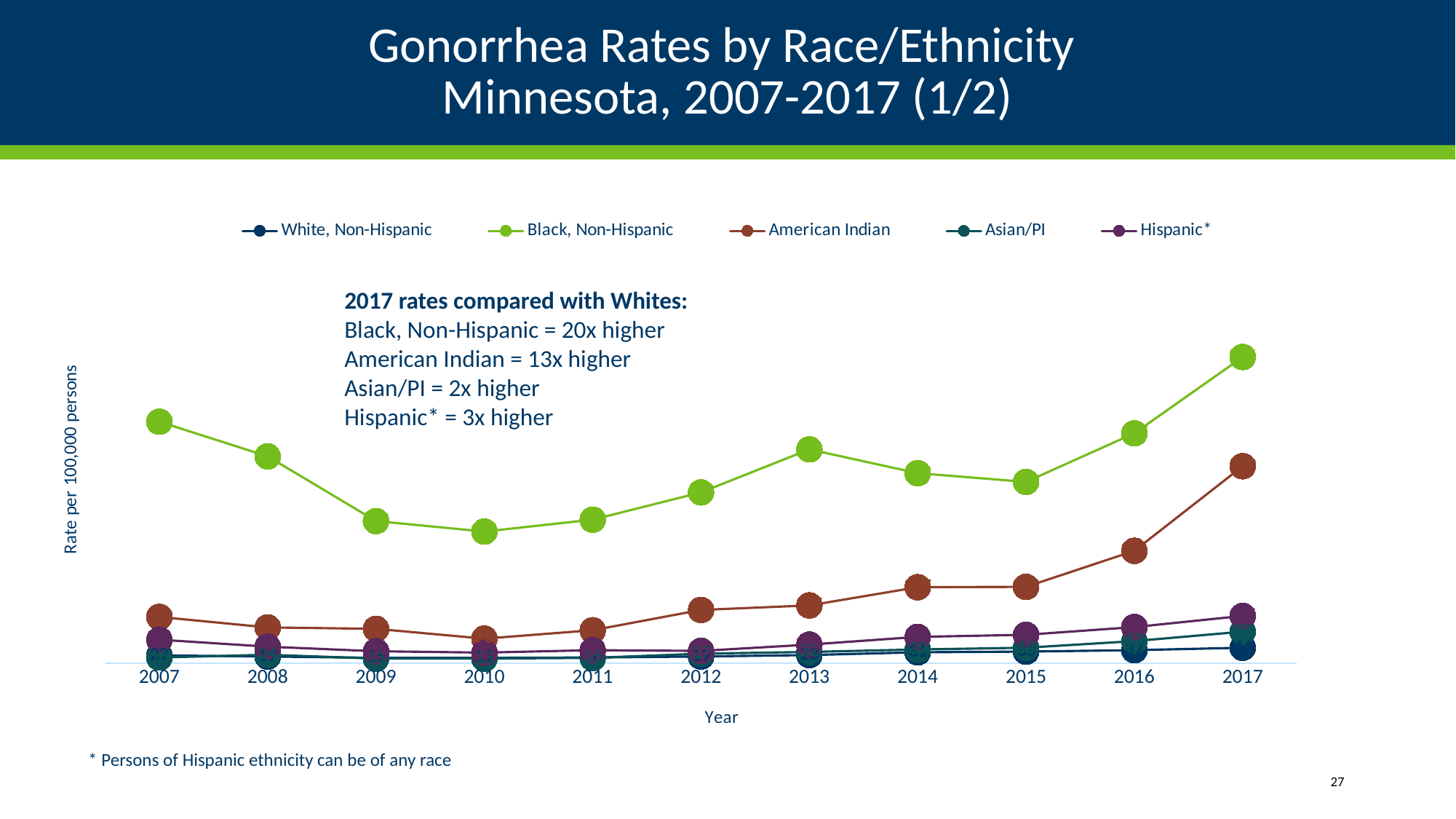
Does the American Indian rate rise or fall from 2013 to 2017? rise Which race/ethnicity group has the lowest gonorrhea rate in 2017? White, Non-Hispanic What kind of chart is shown on the slide? line chart What is the label on the y axis? Rate per 100,000 persons How many years are plotted along the x axis? 11 In 2017, which is higher: the rate for Black, Non-Hispanic or for American Indian? Black, Non-Hispanic In which year is the Black, Non-Hispanic rate at its highest? 2017 How many series does the legend list? 5 According to the slide text, how many times higher than the White rate is the Black, Non-Hispanic rate in 2017? 20x higher Which race/ethnicity group has the highest gonorrhea rate in 2017? Black, Non-Hispanic In which year is the Black, Non-Hispanic rate at its lowest? 2010 Does the Black, Non-Hispanic rate rise or fall from 2007 to 2010? fall